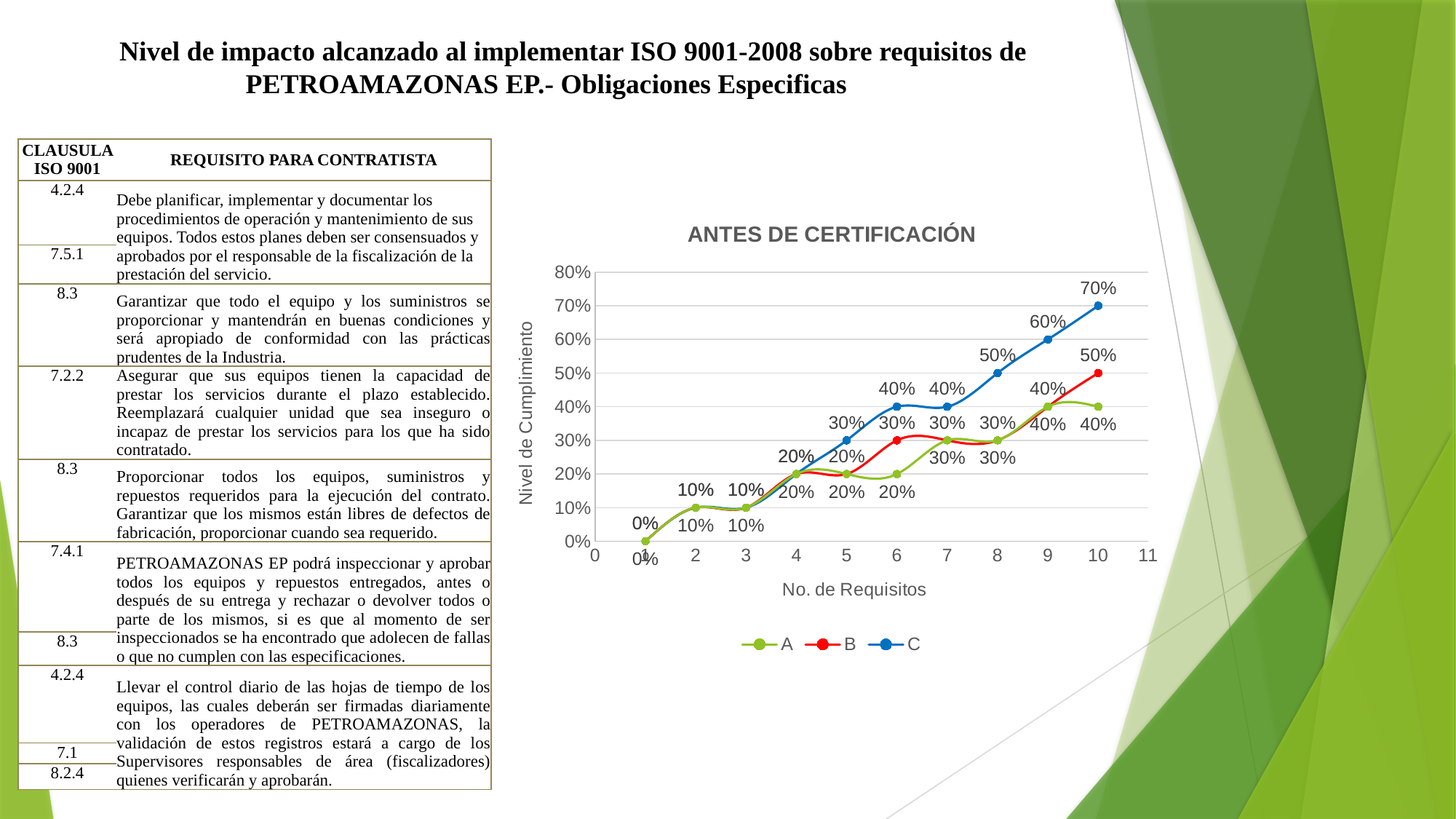
Do the values of series C rise or fall as the requisito number increases? Rise How many series does the legend list? 3 What is the difference between series C and series A at requisito 10? 30% At which requisito number does series C reach its highest value? 10 How many data points does each series have? 10 What is the title of the chart? ANTES DE CERTIFICACIÓN What is the value of series C at requisito 5? 30% What is the value of series C at requisito 10? 70% What is the value of series B at requisito 10? 50% What is the value of series A at requisito 6? 20% What kind of chart is shown? Line chart At requisito 6, which series has the larger value, B or A? B